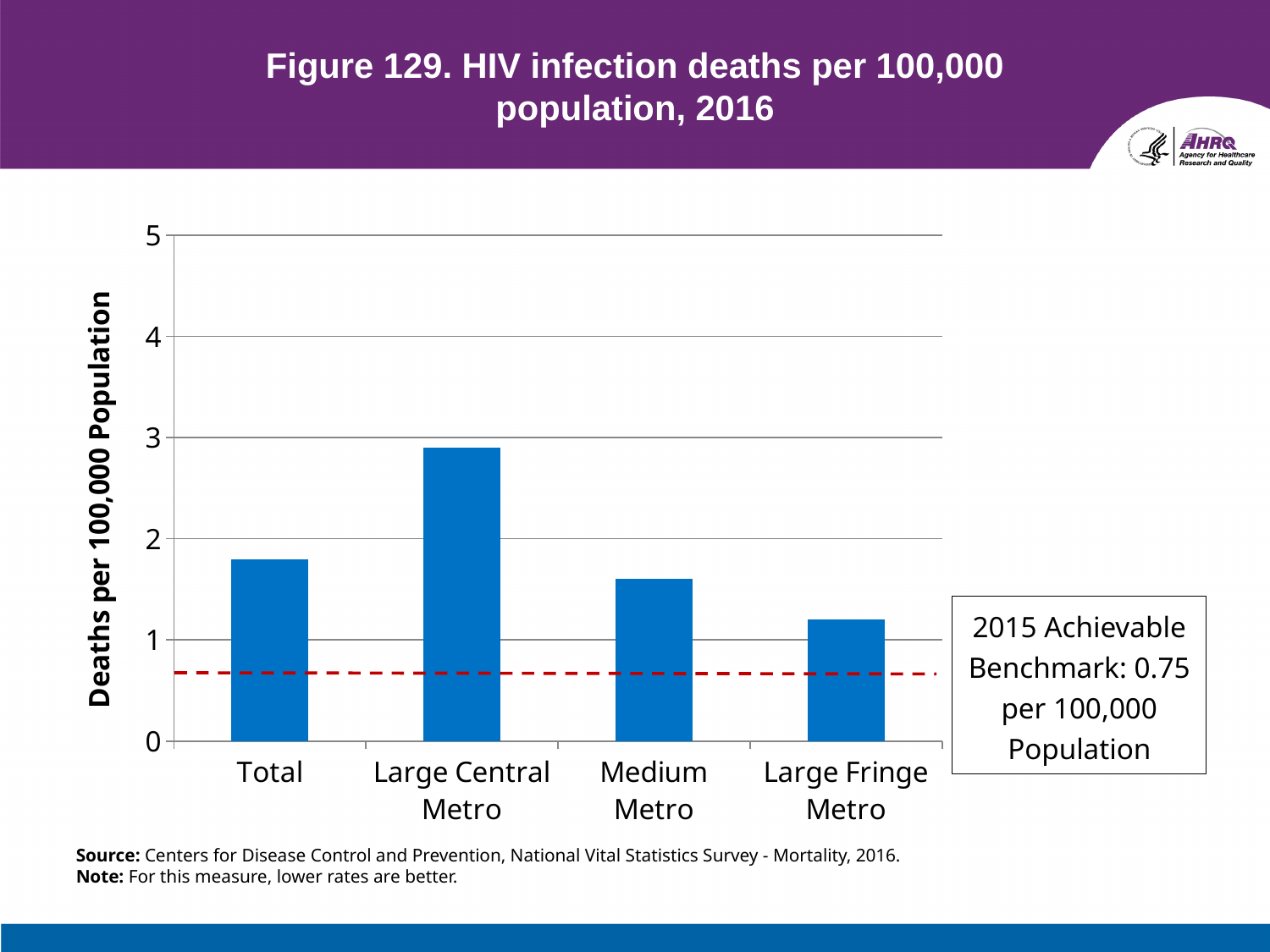
What kind of chart is shown on the slide? bar chart Which category has the lowest HIV infection death rate? Large Fringe Metro Which category has the highest HIV infection death rate? Large Central Metro How many categories are shown on the x axis of the chart? 4 Which is larger, the value for Large Central Metro or the value for Large Fringe Metro? Large Central Metro What is the label of the y axis? Deaths per 100,000 Population Is the value for Total greater or less than 1? greater Is the value for Large Central Metro greater or less than 2? greater Is the value for Large Fringe Metro greater or less than 2? less Which is larger, the value for Total or the value for Medium Metro? Total What is the 2015 achievable benchmark shown on the slide? 0.75 per 100,000 Population